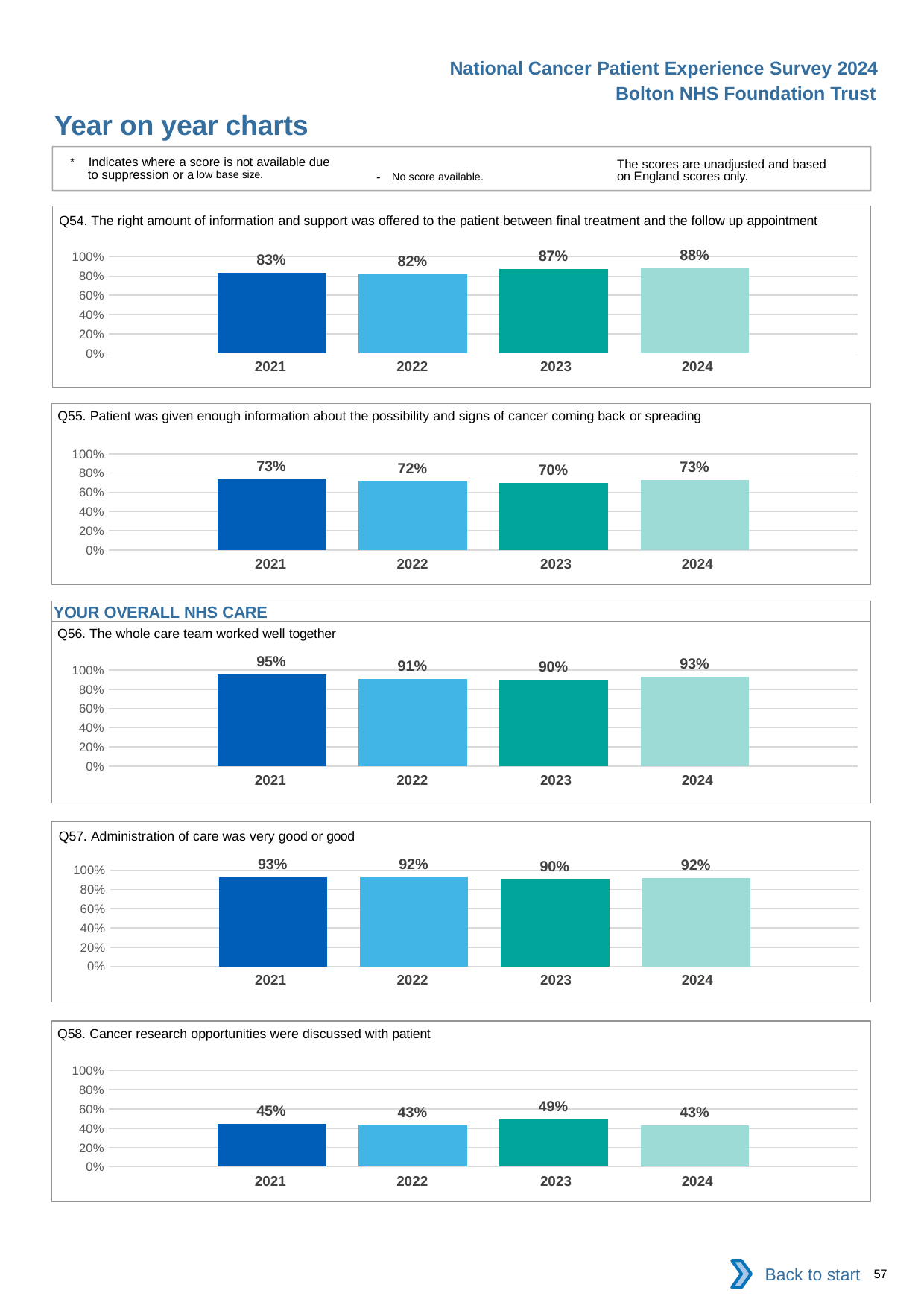
What kind of chart is the Q54 chart? Bar chart In the Q58 chart, what is the difference between the 2023 and 2024 values? 6% In the Q57 chart, what is the value for 2024? 92% In the Q54 chart, which year has the lowest value? 2022 In the Q57 chart, which is larger, the value for 2021 or the value for 2023? 2021 In the Q56 chart, which year has the highest value? 2021 In the Q55 chart, what is the difference between the 2021 and 2023 values? 3% In the Q55 chart, what is the value for 2023? 70% How many bars are in the Q58 chart? 4 In the Q58 chart, which year has the highest value? 2023 In the Q54 chart, what is the value for 2024? 88% In the Q56 chart, what is the value for 2022? 91%